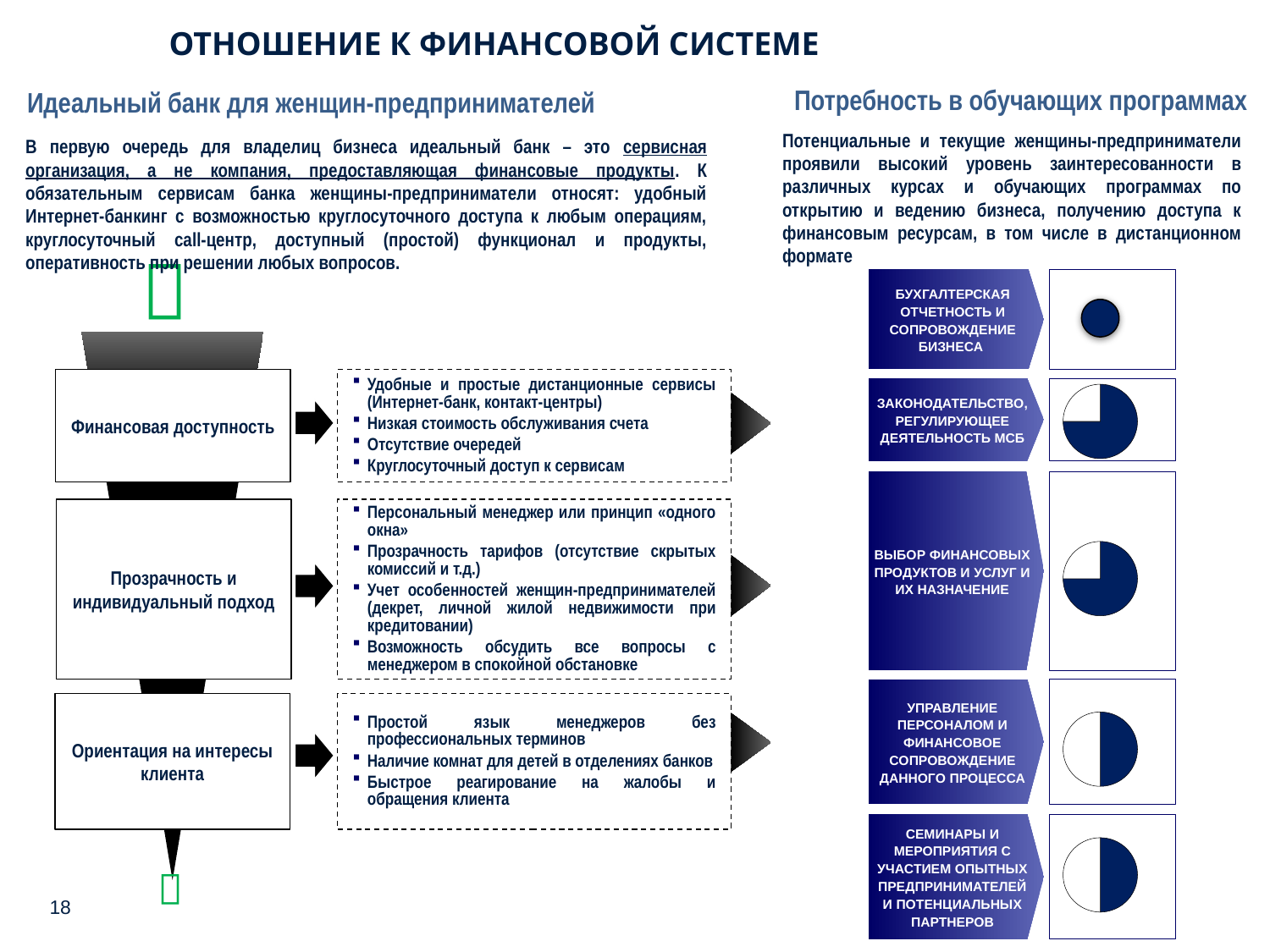
What label is next to the topmost pie chart on the slide? Бухгалтерская отчетность и сопровождение бизнеса Which pie chart shows a larger filled share: the one for «Выбор финансовых продуктов и услуг и их назначение» or the one for «Семинары и мероприятия с участием опытных предпринимателей и потенциальных партнеров»? Выбор финансовых продуктов и услуг и их назначение Which training programme's pie chart shows the largest filled share? Бухгалтерская отчетность и сопровождение бизнеса What is the heading above the section containing the pie charts? Потребность в обучающих программах What kind of charts are shown on the right side of the slide next to the training programme labels? pie charts How many pie charts are shown on the right side of the slide? 5 Which pie chart shows a larger filled share: the one for «Законодательство, регулирующее деятельность МСБ» or the one for «Управление персоналом и финансовое сопровождение данного процесса»? Законодательство, регулирующее деятельность МСБ Which pie chart shows a larger filled share: the one for «Бухгалтерская отчетность и сопровождение бизнеса» or the one for «Семинары и мероприятия с участием опытных предпринимателей и потенциальных партнеров»? Бухгалтерская отчетность и сопровождение бизнеса